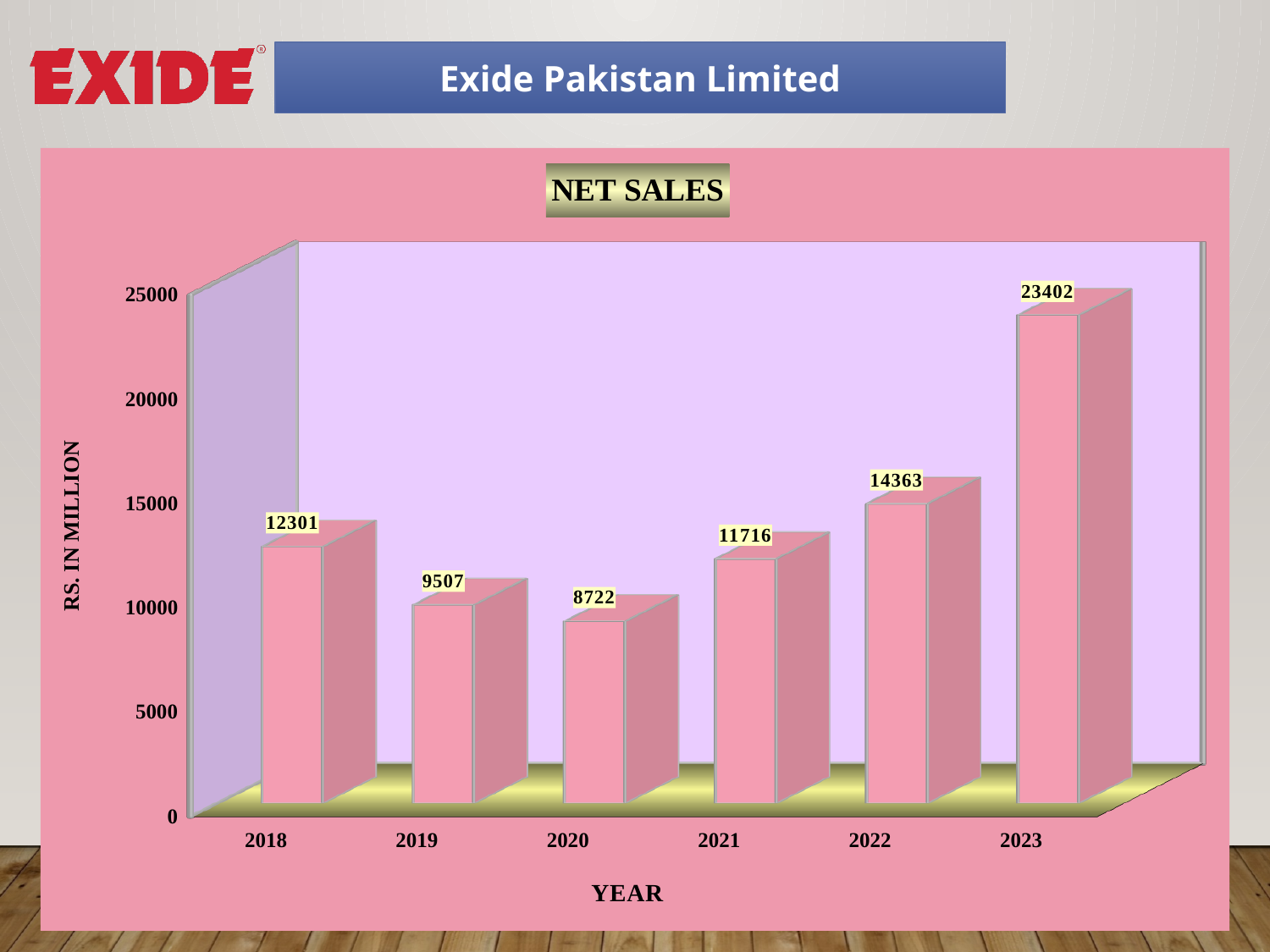
Which year has the lowest net sales? 2020 How many years are shown on the chart? 6 What kind of chart is shown on the slide? bar chart Which year has the highest net sales? 2023 Which year has higher net sales, 2018 or 2021? 2018 What is the title of the chart? NET SALES What is the difference in net sales between 2018 and 2019? 2794 What is the net sales value for 2020? 8722 Is the net sales value for 2022 greater or less than 15000? less What is the net sales value for 2021? 11716 What is the difference in net sales between 2023 and 2022? 9039 What is the net sales value for 2023? 23402